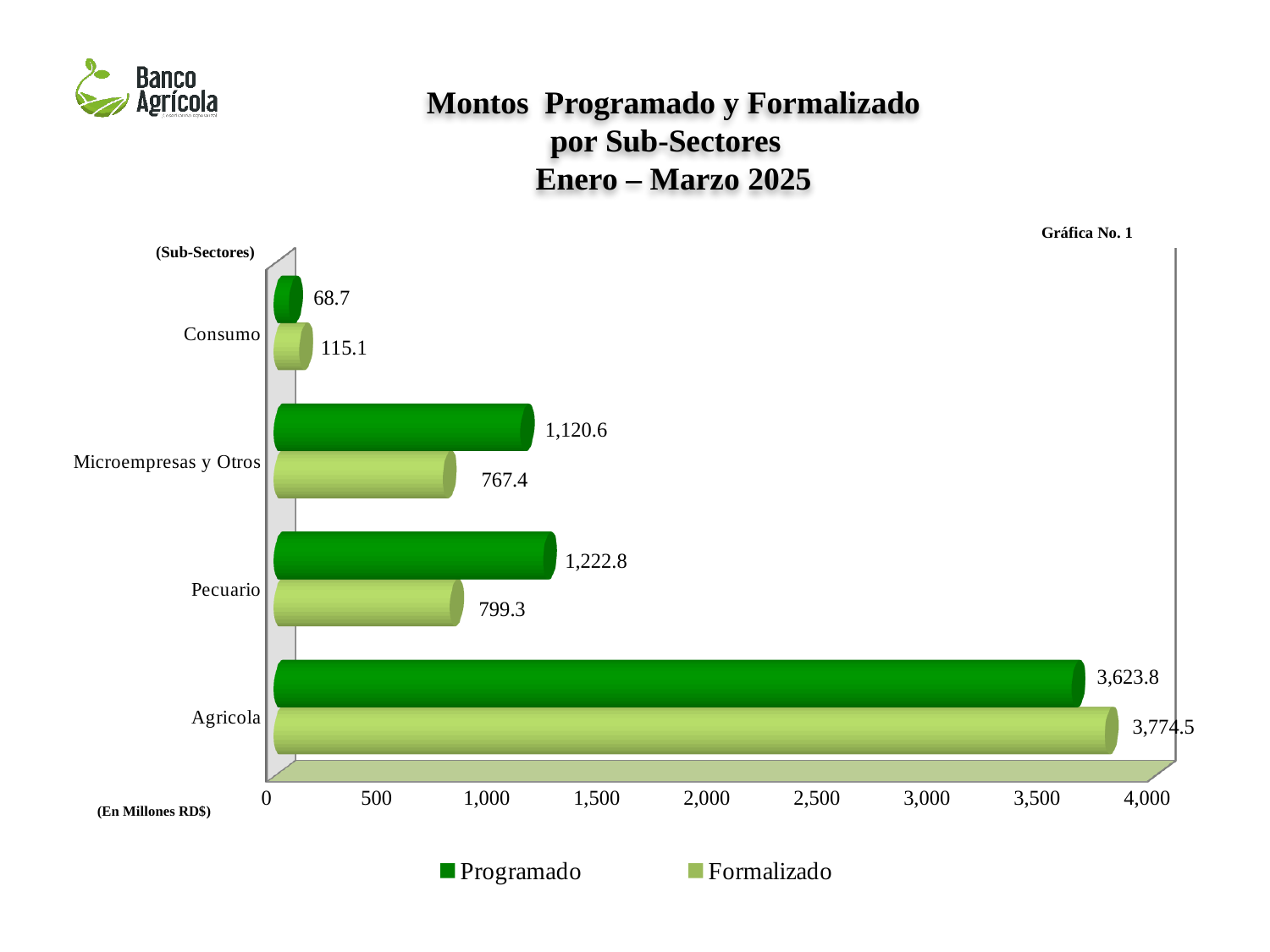
What unit is stated for the values on the chart? En Millones RD$ What kind of chart is shown on the slide? Bar chart What is the difference between the Formalizado and Programado values for Agricola? 150.7 How many series does the legend list? 2 Which is larger for Microempresas y Otros, Programado or Formalizado? Programado What is the Formalizado value for Consumo? 115.1 How many sub-sectors are shown on the chart? 4 Which sub-sector has the lowest Programado value? Consumo Is the Programado value for Pecuario greater or less than 1,000? greater What is the Formalizado value for Pecuario? 799.3 Which sub-sector has the highest Formalizado value? Agricola What is the Programado value for Agricola? 3,623.8